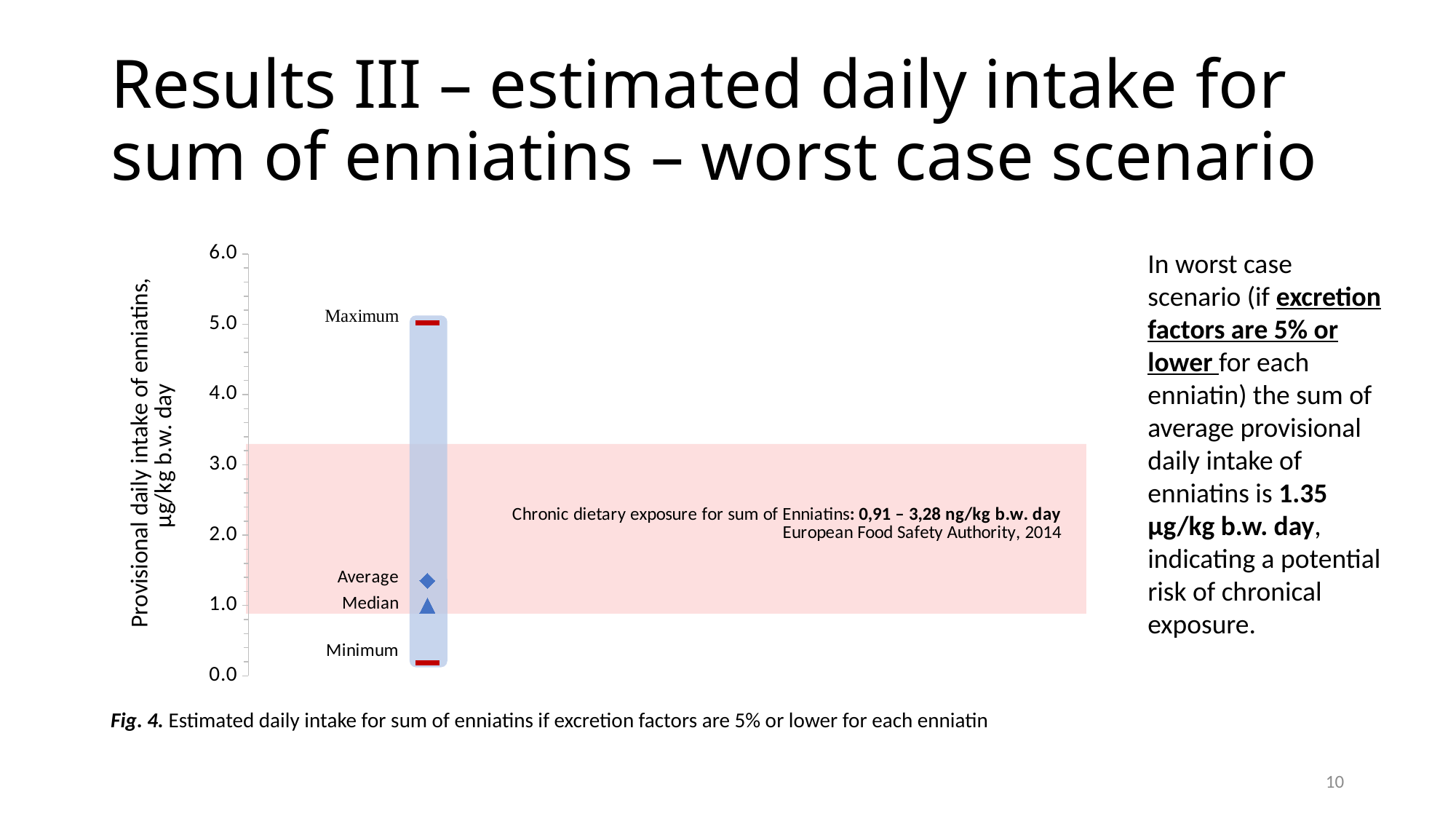
How many labelled markers (statistics) are shown on the chart? 4 Is the Minimum value in the chart greater or less than 1.0? less Which labelled marker in the chart has the highest value? Maximum What is the highest tick value shown on the y axis of the chart? 6.0 Is the Average value in the chart greater or less than 2.0? less What is the label of the y axis of the chart? Provisional daily intake of enniatins, µg/kg b.w. day Which labelled marker in the chart has the lowest value? Minimum According to the slide, what is the sum of average provisional daily intake of enniatins in the worst case scenario? 1.35 µg/kg b.w. day Is the Median value in the chart greater or less than 3.0? less Which is higher in the chart, the Average or the Median? Average What chronic dietary exposure range for the sum of enniatins is indicated by the shaded band on the chart? 0,91 – 3,28 ng/kg b.w. day